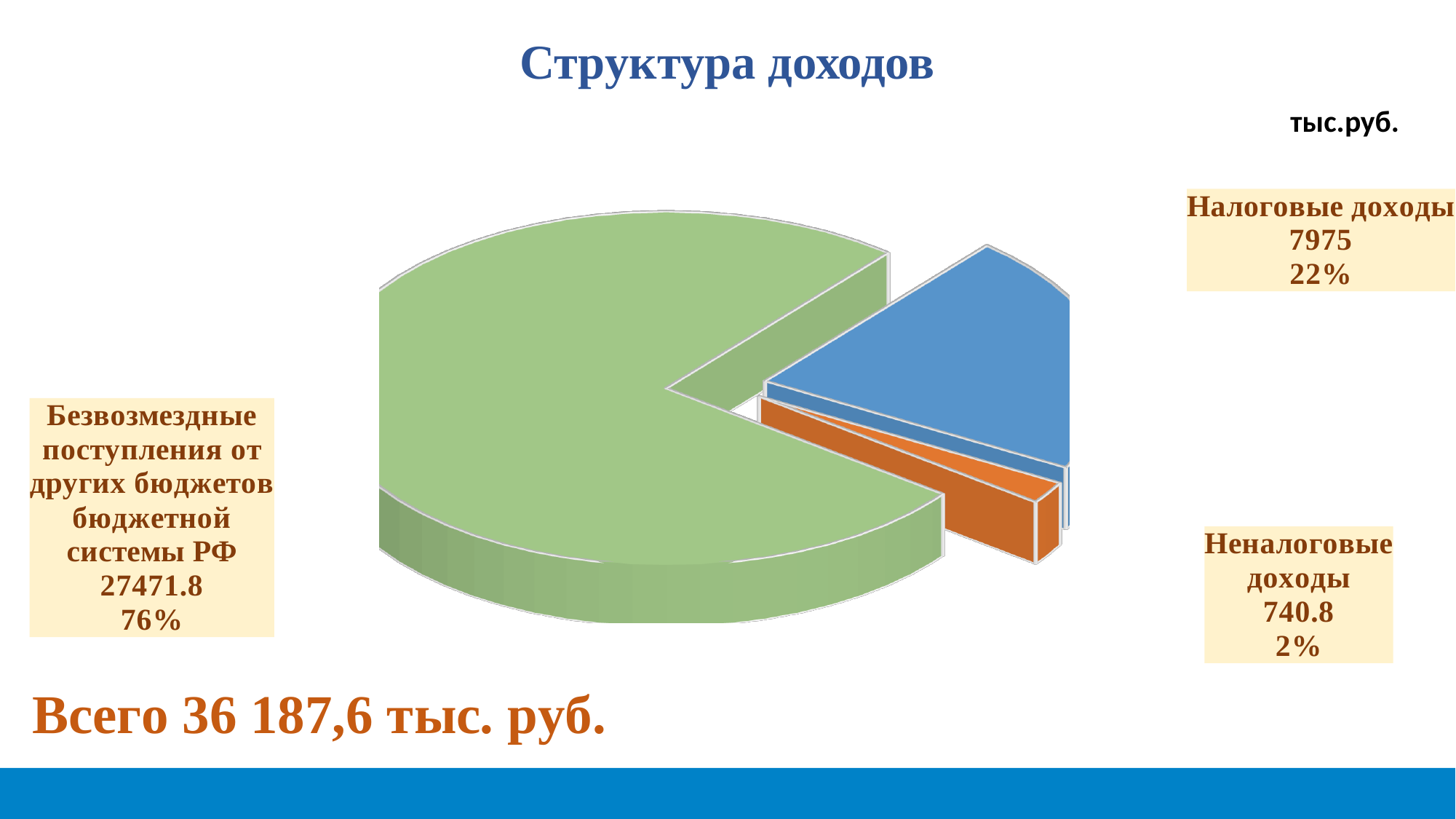
Which category has the largest slice of the pie? Безвозмездные поступления от других бюджетов бюджетной системы РФ What is the total of all revenues shown on the slide? 36 187,6 тыс. руб. What share of the pie does Налоговые доходы represent? 22% What is the value for Безвозмездные поступления от других бюджетов бюджетной системы РФ? 27471.8 What is the value for Налоговые доходы? 7975 What is the title of the chart? Структура доходов Which is larger, Налоговые доходы or Неналоговые доходы? Налоговые доходы What type of chart is shown on the slide? Pie chart What share of the pie does Безвозмездные поступления от других бюджетов бюджетной системы РФ represent? 76% How many slices does the pie chart have? 3 What is the value for Неналоговые доходы? 740.8 Which category has the smallest slice of the pie? Неналоговые доходы